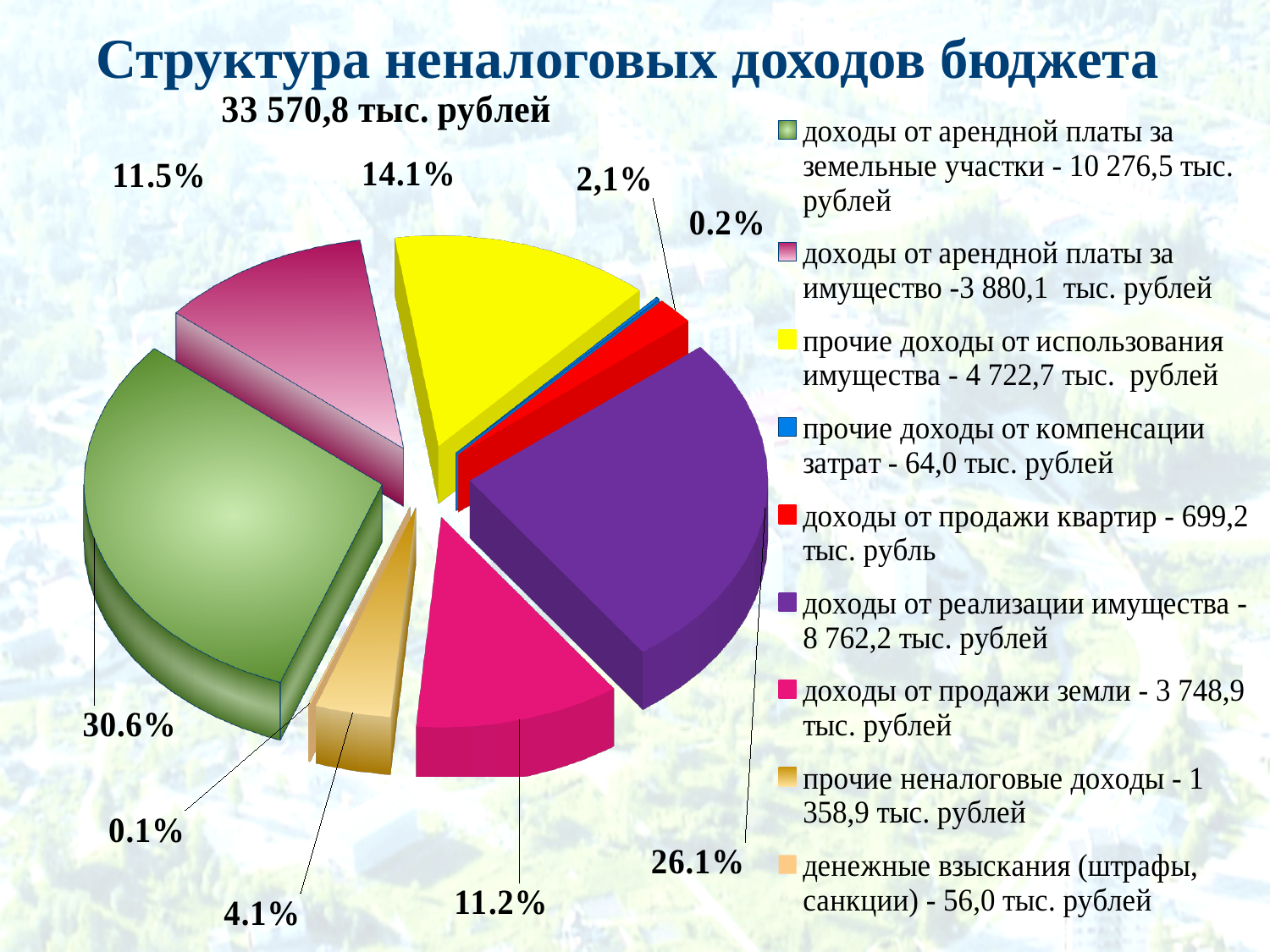
What is the title of the chart? 33 570,8 тыс. рублей Which is larger: доходы от арендной платы за имущество or доходы от продажи земли? доходы от арендной платы за имущество Which category has the largest share of the pie? доходы от арендной платы за земельные участки How many entries does the legend list? 9 What is the value for доходы от продажи квартир? 699,2 тыс. рубль What is the value for доходы от арендной платы за земельные участки? 10 276,5 тыс. рублей What kind of chart is shown on the slide? pie chart What share of the pie is доходы от реализации имущества? 26.1% Which category has the smallest share of the pie? денежные взыскания (штрафы, санкции) How many slices does the pie chart have? 9 What is the difference between доходы от арендной платы за земельные участки and доходы от реализации имущества? 1 514,3 тыс. рублей What total amount is shown under the chart title? 33 570,8 тыс. рублей